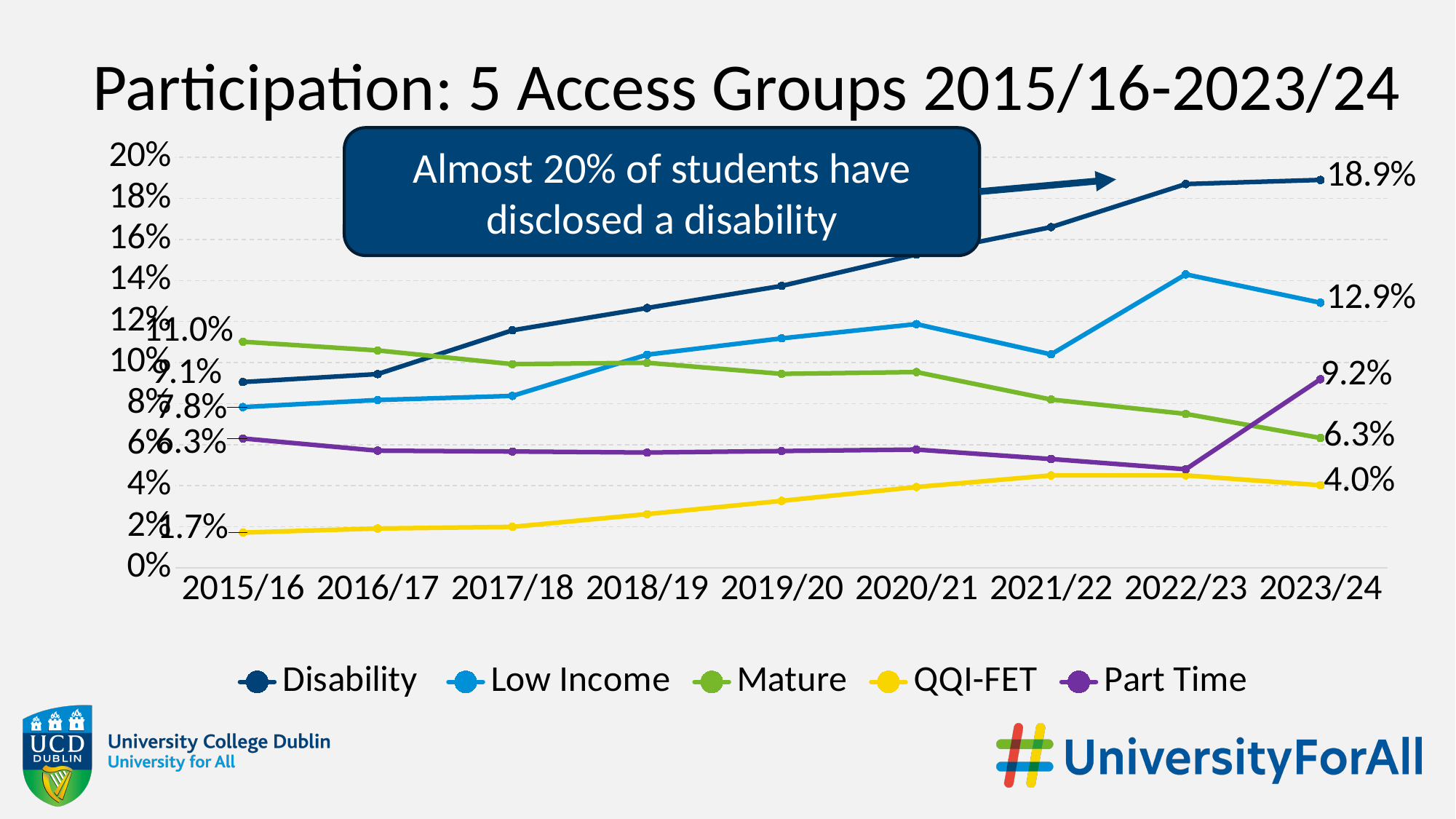
How many academic years are shown on the x axis? 9 What is the value for Disability in 2023/24? 18.9% What is the value for QQI-FET in 2015/16? 1.7% Which series has the highest value in 2023/24? Disability Which series has the lowest value in 2015/16? QQI-FET What is the value for Low Income in 2023/24? 12.9% What is the difference between the Disability value in 2023/24 and in 2015/16? 9.8% Does the Mature series rise or fall from 2015/16 to 2023/24? fall What is the value for Mature in 2015/16? 11.0% Is the value for Part Time in 2019/20 greater or less than 8%? less What kind of chart is shown on the slide? line chart How many series does the legend list? 5